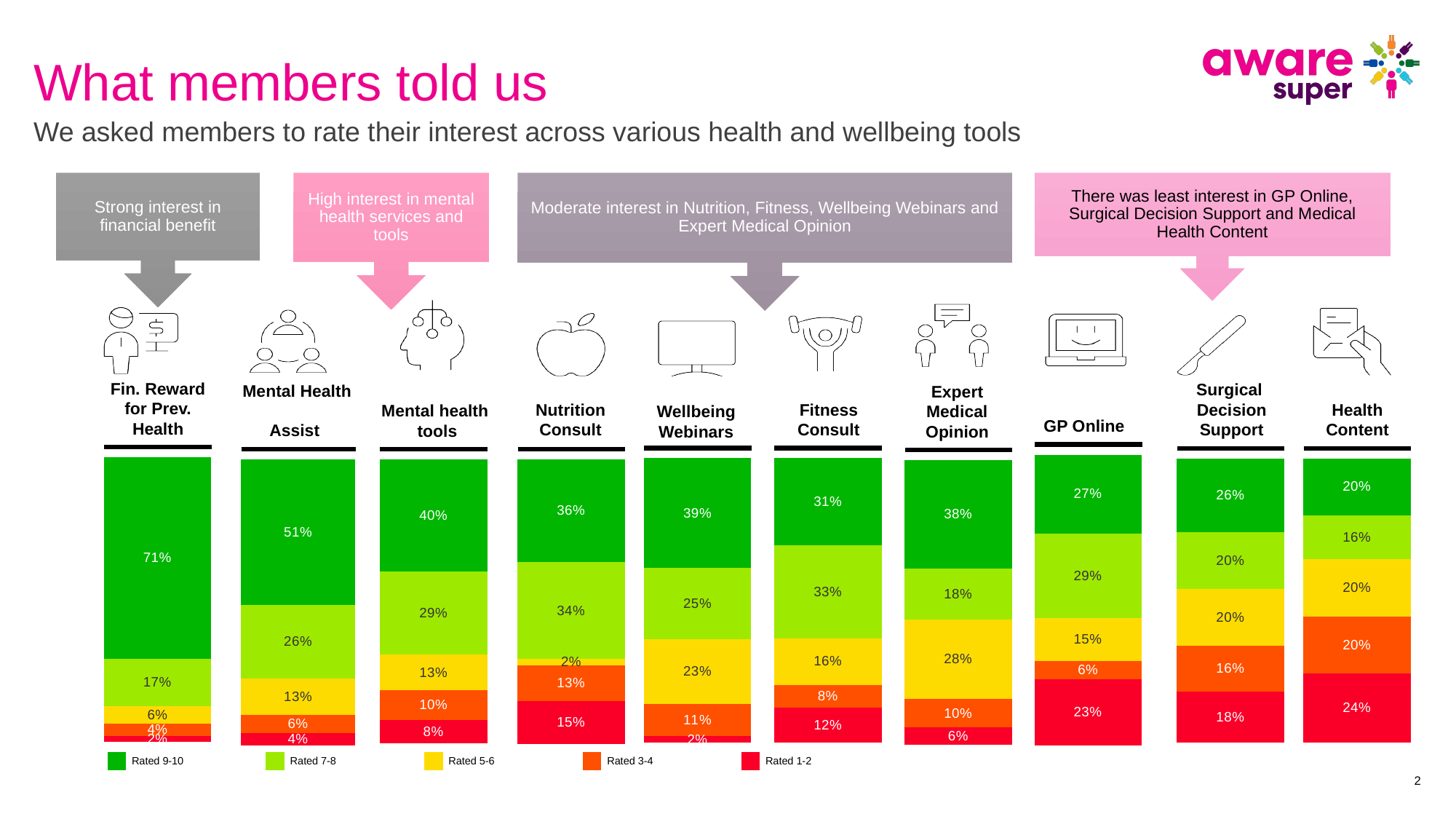
Which tool has the highest share of members rating it 9-10? Fin. Reward for Prev. Health What percentage of members rated Expert Medical Opinion 5-6? 28% How many rating bands does the legend list? 5 Which has a larger Rated 1-2 share, Health Content or Surgical Decision Support? Health Content What percentage of members rated Mental Health Assist 7-8? 26% What percentage of members rated GP Online 1-2? 23% What is the difference between the Rated 9-10 share for Mental Health Assist and for Mental health tools? 11% Which colour represents the Rated 1-2 band in the legend? Red Which tool has the lowest share of members rating it 9-10? Health Content What kind of chart is shown on the slide? Stacked bar chart What percentage of members rated Fin. Reward for Prev. Health 9-10? 71% How many health and wellbeing tools are shown in the chart? 10